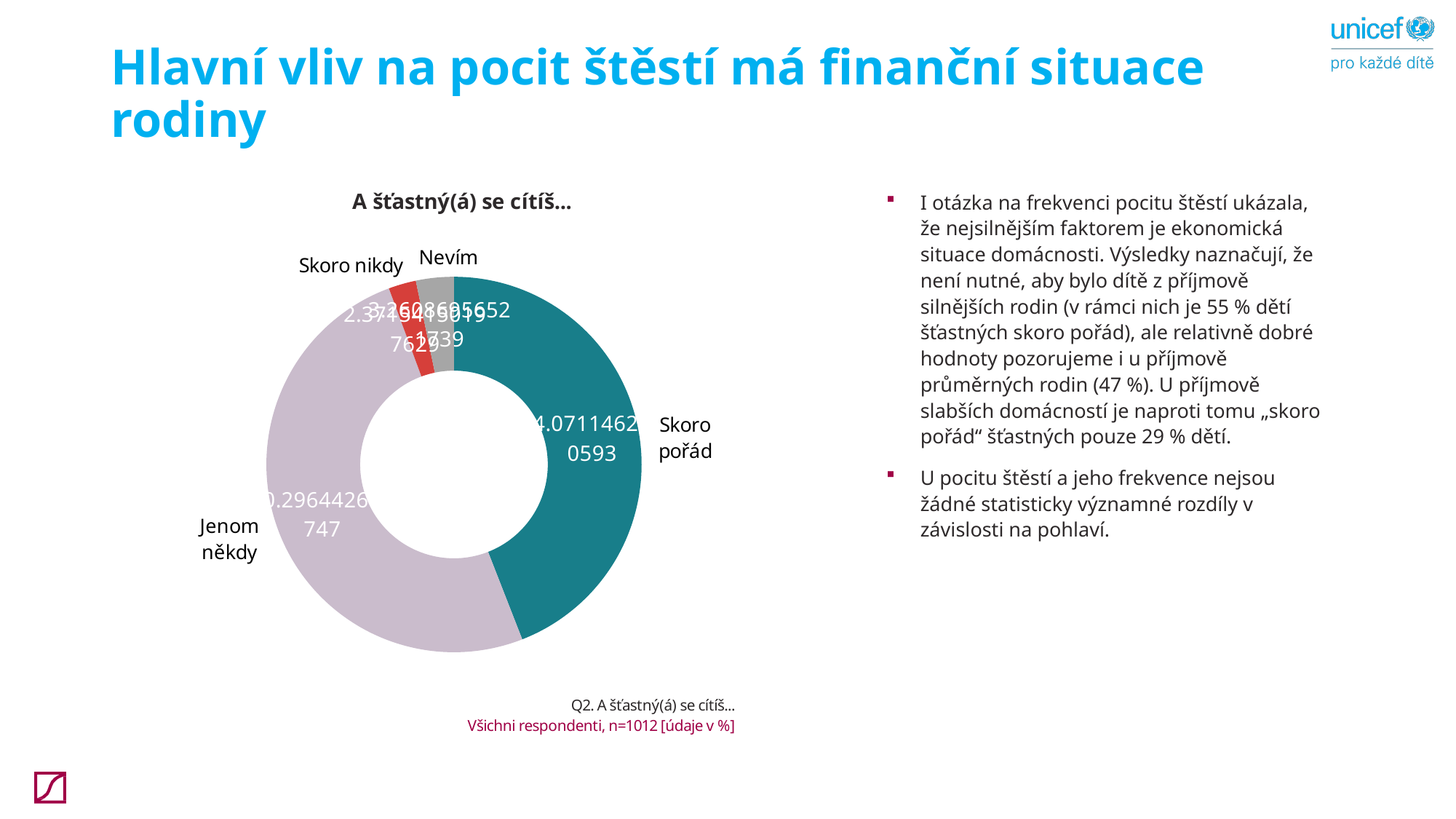
Which slice is larger, Skoro pořád or Nevím? Skoro pořád What colour is the Skoro pořád slice? Teal Which slice is larger, Jenom někdy or Nevím? Jenom někdy Which category is shown in red? Skoro nikdy How many categories (slices) does the chart show? 4 What is the title of the chart? A šťastný(á) se cítíš… What kind of chart is shown on the slide? Donut (pie) chart Which category has the largest slice in the chart? Jenom někdy Which slice is larger, Skoro pořád or Skoro nikdy? Skoro pořád